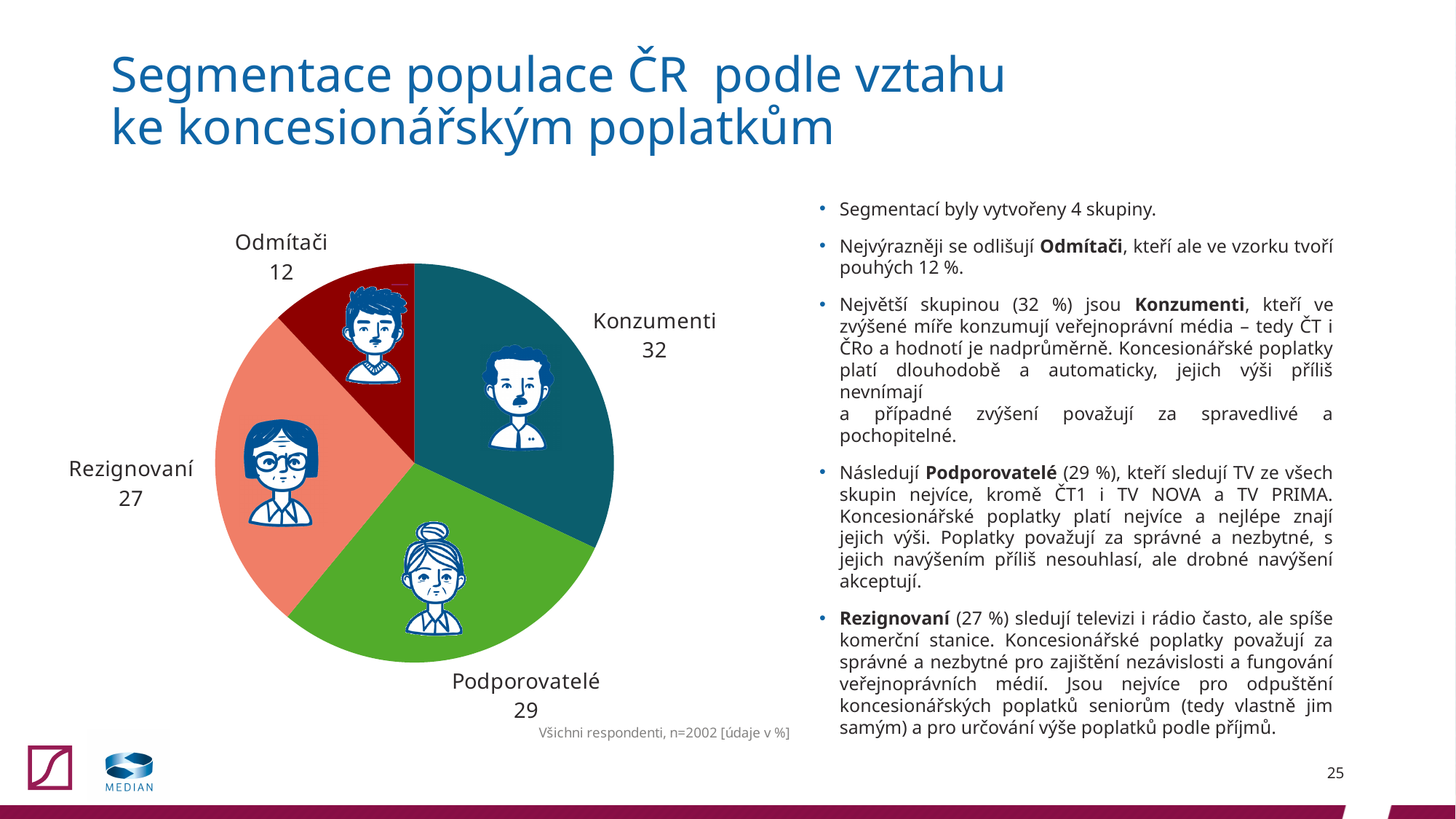
What is the value for Odmítači? 12 What is the difference between the values for Podporovatelé and Rezignovaní? 2 What kind of chart is shown on the slide? pie chart What is the value for Rezignovaní? 27 Which segment has the smallest share of the pie? Odmítači What is the value for Podporovatelé? 29 Which segment has the largest share of the pie? Konzumenti Which is larger, Rezignovaní or Odmítači? Rezignovaní What colour is the Podporovatelé slice? green What is the value for Konzumenti? 32 How many segments does the pie chart have? 4 What is the difference between the values for Konzumenti and Odmítači? 20